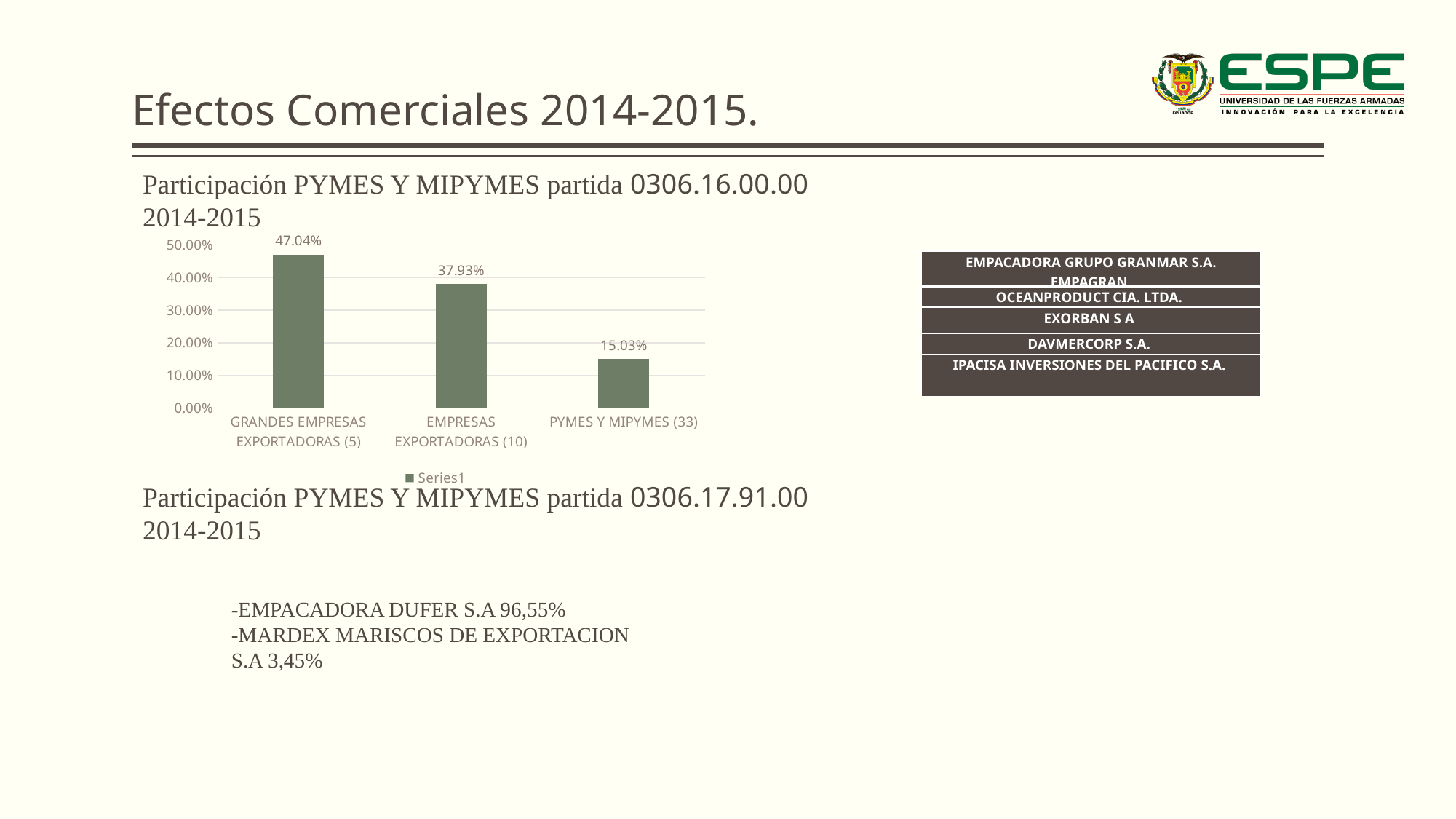
What is the legend entry shown below the chart? Series1 Which category has the lowest value? PYMES Y MIPYMES (33) What is the value for PYMES Y MIPYMES (33)? 15.03% Which is larger, the value for EMPRESAS EXPORTADORAS (10) or the value for PYMES Y MIPYMES (33)? EMPRESAS EXPORTADORAS (10) Is the value for PYMES Y MIPYMES (33) greater or less than 20.00%? less What is the value for GRANDES EMPRESAS EXPORTADORAS (5)? 47.04% Which category has the highest value? GRANDES EMPRESAS EXPORTADORAS (5) What kind of chart is shown on the slide? bar chart What is the difference between the values for GRANDES EMPRESAS EXPORTADORAS (5) and EMPRESAS EXPORTADORAS (10)? 9.11% What is the value for EMPRESAS EXPORTADORAS (10)? 37.93% What is the difference between the values for EMPRESAS EXPORTADORAS (10) and PYMES Y MIPYMES (33)? 22.90% How many categories are shown in the chart? 3